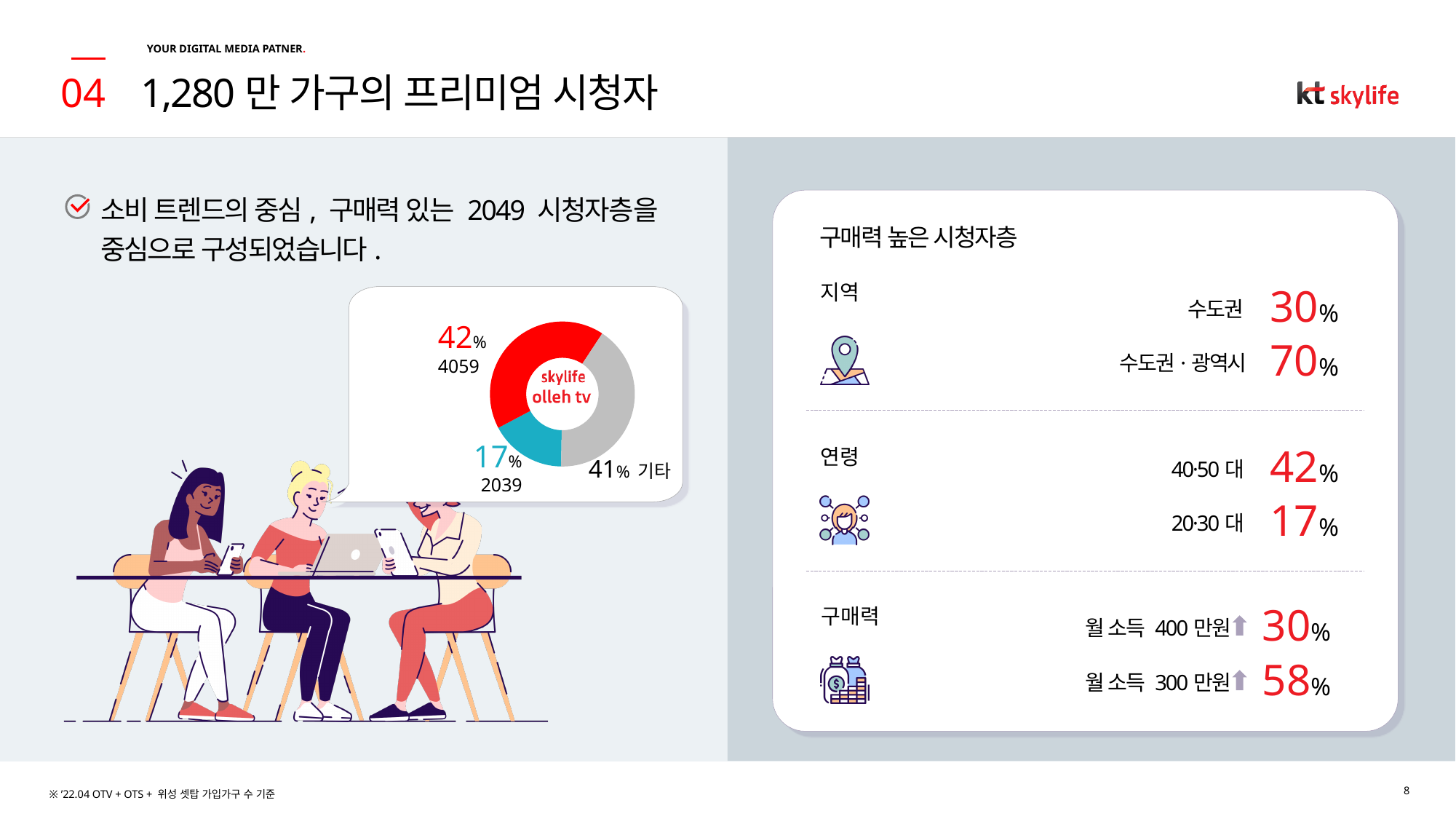
Which segment of the donut chart is the largest? 4059 What percentage of the donut chart is the 기타 segment? 41% How many segments does the donut chart have? 3 What colour is the 2039 segment of the donut chart? cyan What kind of chart is shown on the slide? donut chart What percentage of the donut chart is the 4059 segment? 42% What share of the donut chart do the 4059 and 2039 segments make up together? 59% Which is larger in the donut chart, the 2039 segment or the 기타 segment? 기타 What percentage of the donut chart is the 2039 segment? 17% What is the difference in percentage points between the 4059 segment and the 2039 segment? 25 What text is written in the centre of the donut chart? skylife olleh tv Which segment of the donut chart is the smallest? 2039